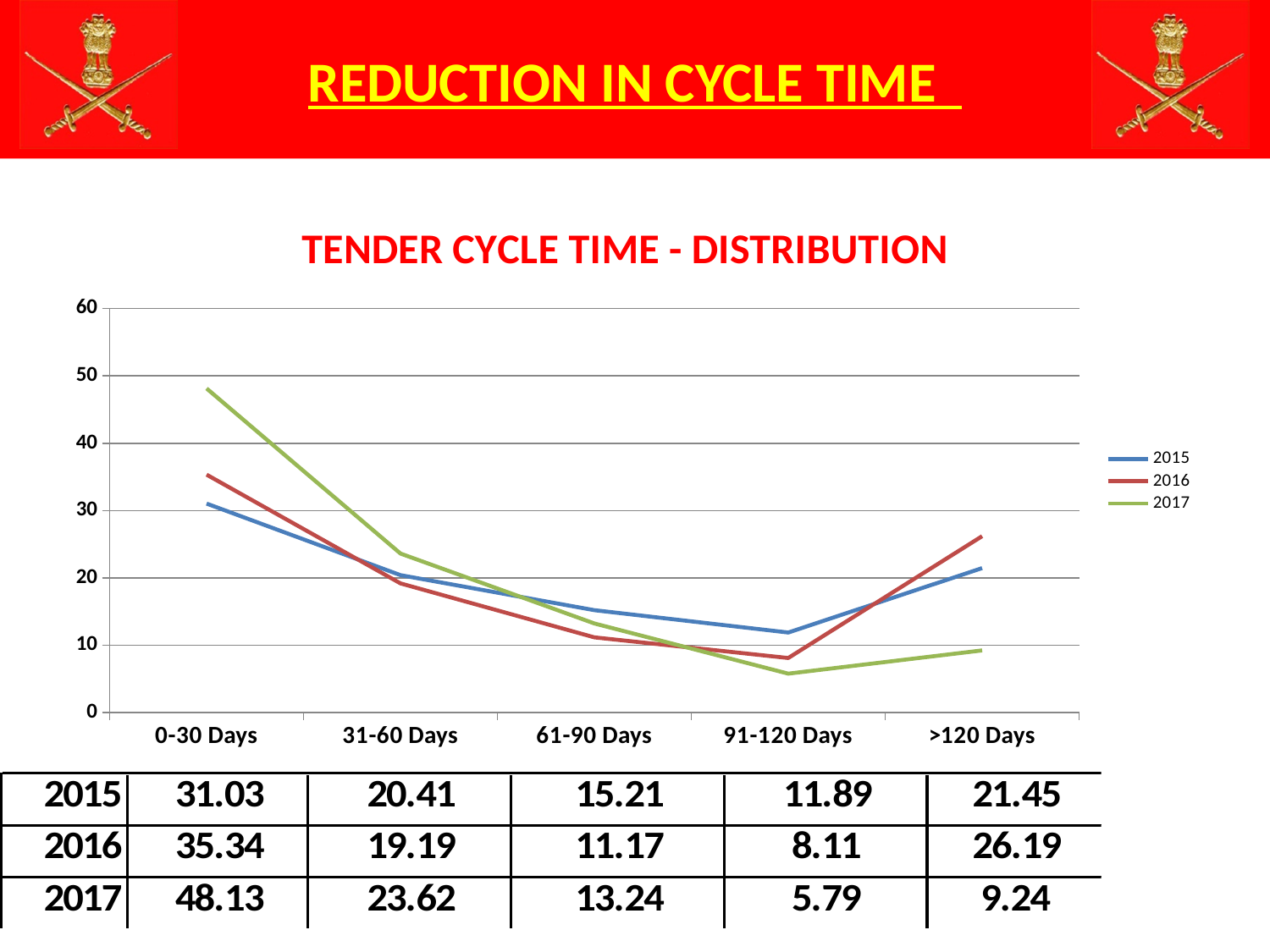
What is the value for 2017 in the 0-30 Days category? 48.13 Which is larger in the >120 Days category, the 2016 value or the 2017 value? 2016 What is the title of the chart? TENDER CYCLE TIME - DISTRIBUTION What is the value for 2015 in the 91-120 Days category? 11.89 Is the value for 2017 in the 0-30 Days category greater or less than 40? greater What kind of chart is shown on the slide? line chart Which category has the lowest value for the 2016 series? 91-120 Days How many series does the legend list? 3 What is the difference between the 2017 and 2015 values in the 0-30 Days category? 17.10 How many categories are shown on the x axis? 5 What is the value for 2016 in the >120 Days category? 26.19 Which category has the highest value for the 2017 series? 0-30 Days